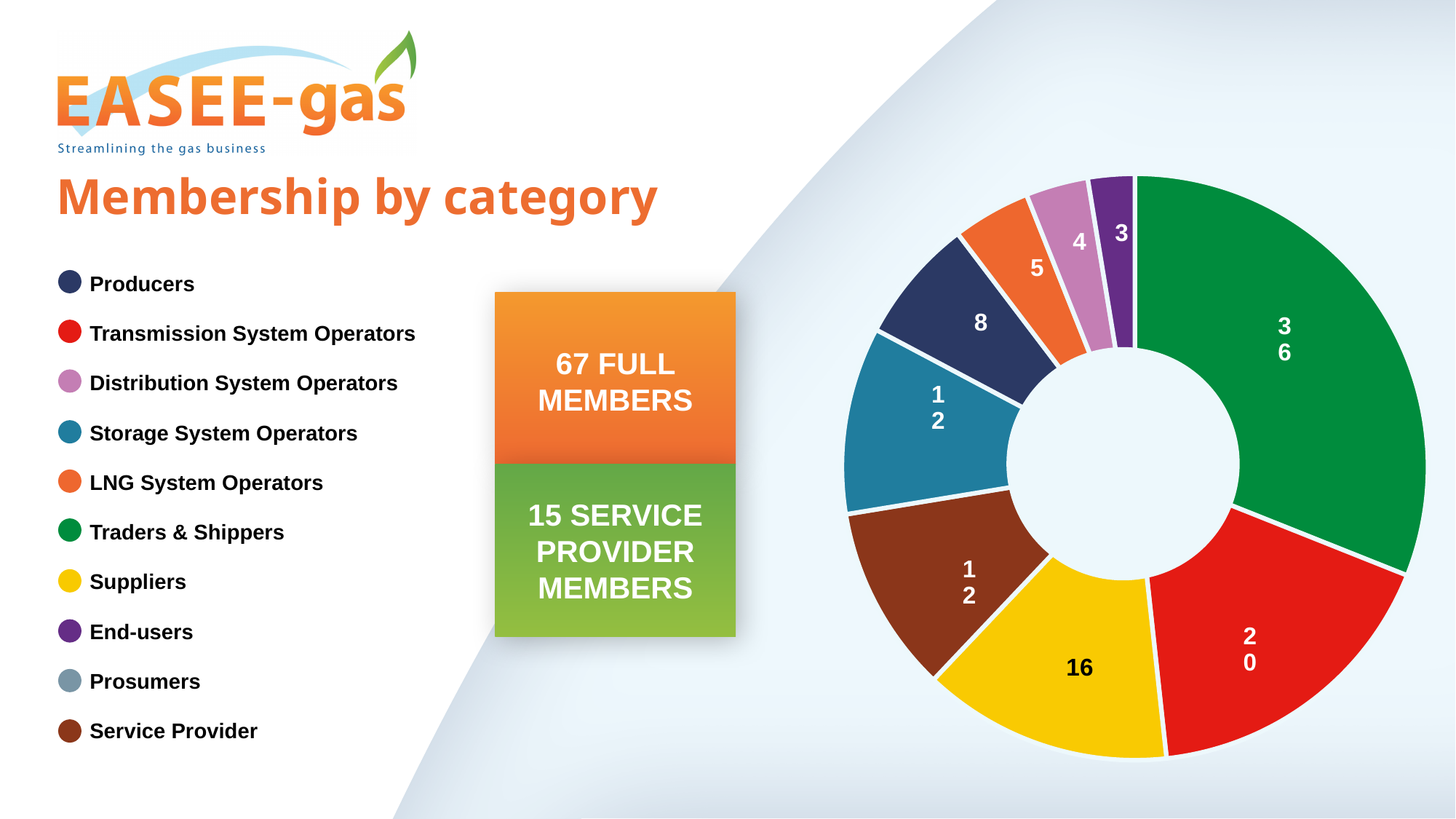
Which category has the smallest labelled slice in the chart? End-users What is the value for Traders & Shippers in the Membership by category chart? 36 What type of chart is shown on the slide? Doughnut chart What is the value for Producers in the chart? 8 How many categories are listed in the chart's legend? 10 What is the value for Suppliers in the chart? 16 What is the value for LNG System Operators in the chart? 5 What is the value for Transmission System Operators in the chart? 20 What is the difference between the values for Traders & Shippers and Transmission System Operators? 16 Which category has the largest slice in the chart? Traders & Shippers Which is larger, the value for Suppliers or the value for Producers? Suppliers What is the title of the chart on the slide? Membership by category